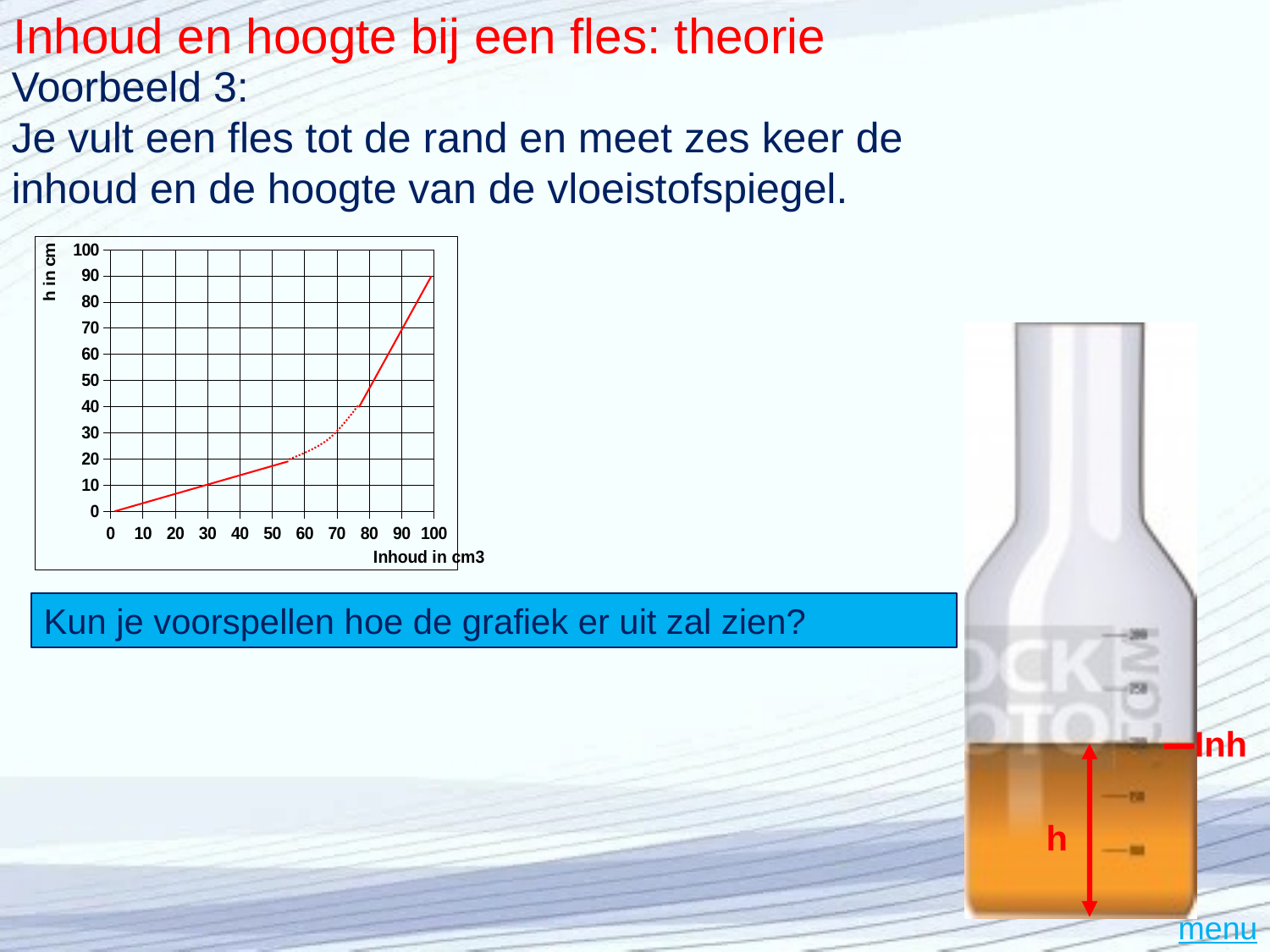
Is the value of h at an Inhoud of 50 cm3 greater or less than 30? less What is the highest value shown on the vertical axis of the chart? 100 What is the value of h in cm when Inhoud is 0 cm3? 0 What is the label of the horizontal axis of the chart? Inhoud in cm3 Is the value of h at an Inhoud of 20 cm3 greater or less than 20? less Is the value of h at an Inhoud of 100 cm3 greater or less than 80? greater How many lines are plotted in the chart? 1 What is the label of the vertical axis of the chart? h in cm Which is larger: the value of h at an Inhoud of 100 cm3 or at an Inhoud of 50 cm3? 100 cm3 What kind of chart is shown on the slide? line chart Does the value of h rise or fall as Inhoud increases along the x axis? rise